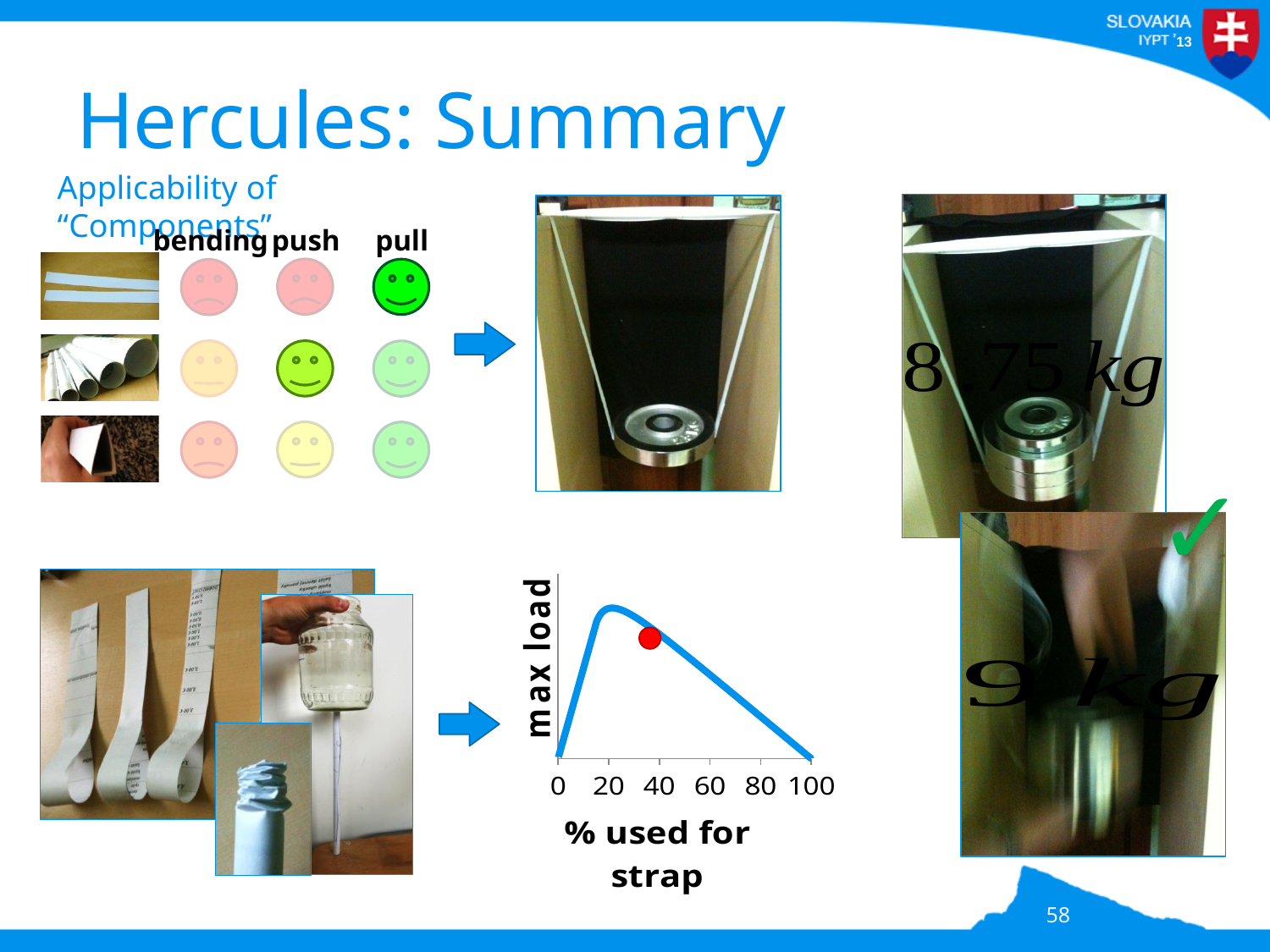
What is the label of the x axis of the line chart? % used for strap What kind of chart is shown at the bottom centre of the slide? line chart In the line chart, does the max load rise or fall as % used for strap goes from 40 to 100? fall In the line chart, is the max load higher at 20% used for strap or at 100% used for strap? 20% In the line chart, does the max load rise or fall as % used for strap goes from 0 to 20? rise In the line chart, is the max load higher at 40% used for strap or at 80% used for strap? 40% In the line chart, is the red dot located at a % used for strap greater or less than 60? less What is the largest tick value shown on the x axis of the line chart? 100 How many tick labels are shown on the x axis of the line chart? 6 What colour is the curve in the line chart? blue What is the label of the y axis of the line chart? max load In the line chart, is the peak of the curve located at a % used for strap greater or less than 60? less